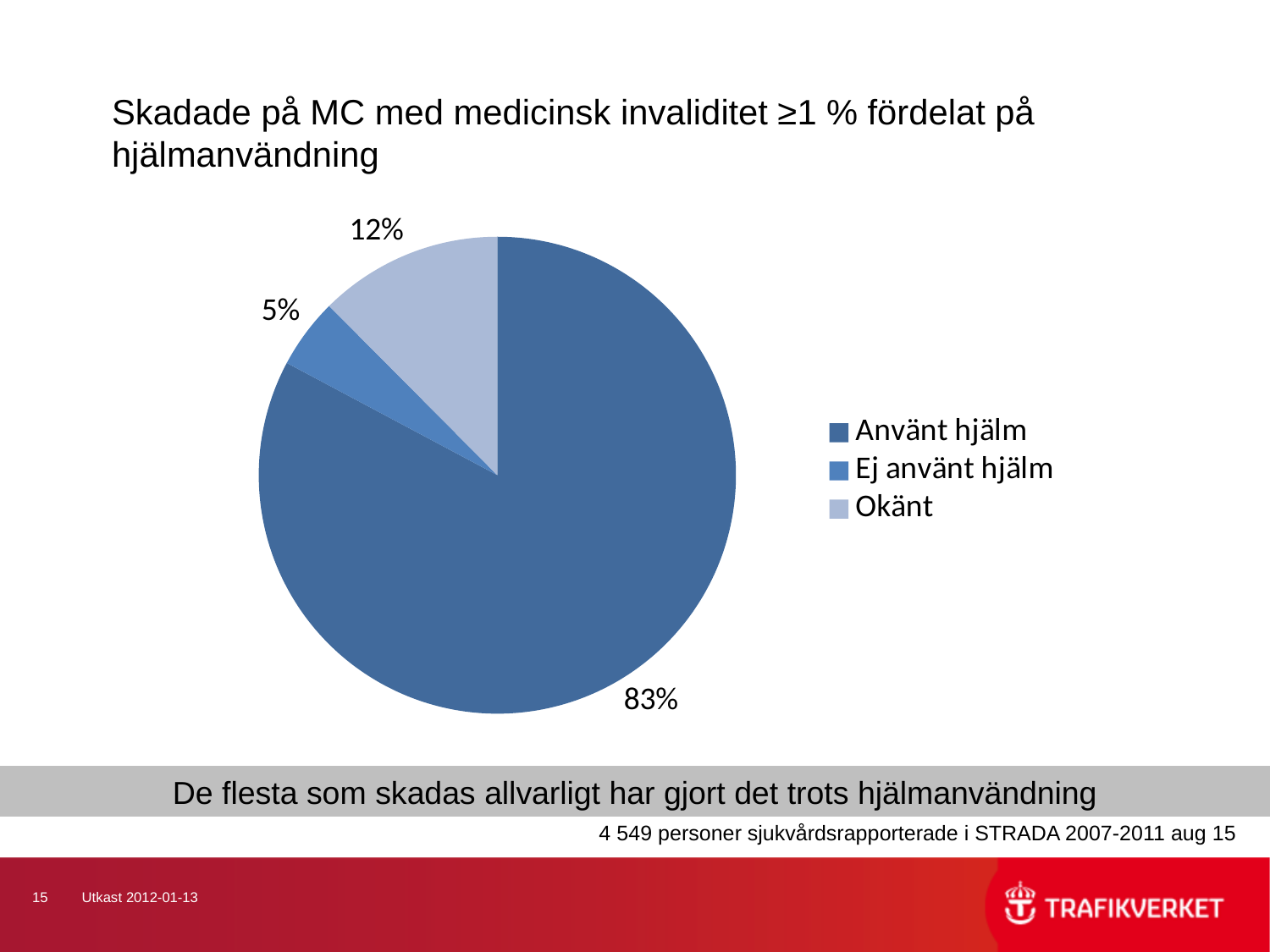
Which is larger, the share for "Okänt" or the share for "Ej använt hjälm"? Okänt What kind of chart is shown on the slide? Pie chart What share of the pie does "Okänt" represent? 12% What share of the pie does "Använt hjälm" represent? 83% How many categories does the pie chart show? 3 Which category has the smallest slice of the pie? Ej använt hjälm How many entries does the legend list? 3 What share of the pie does "Ej använt hjälm" represent? 5% Which legend entry is shown in the lightest blue colour? Okänt Which category has the largest slice of the pie? Använt hjälm What is the difference in percentage points between "Okänt" and "Ej använt hjälm"? 7 What is the difference in percentage points between "Använt hjälm" and "Okänt"? 71